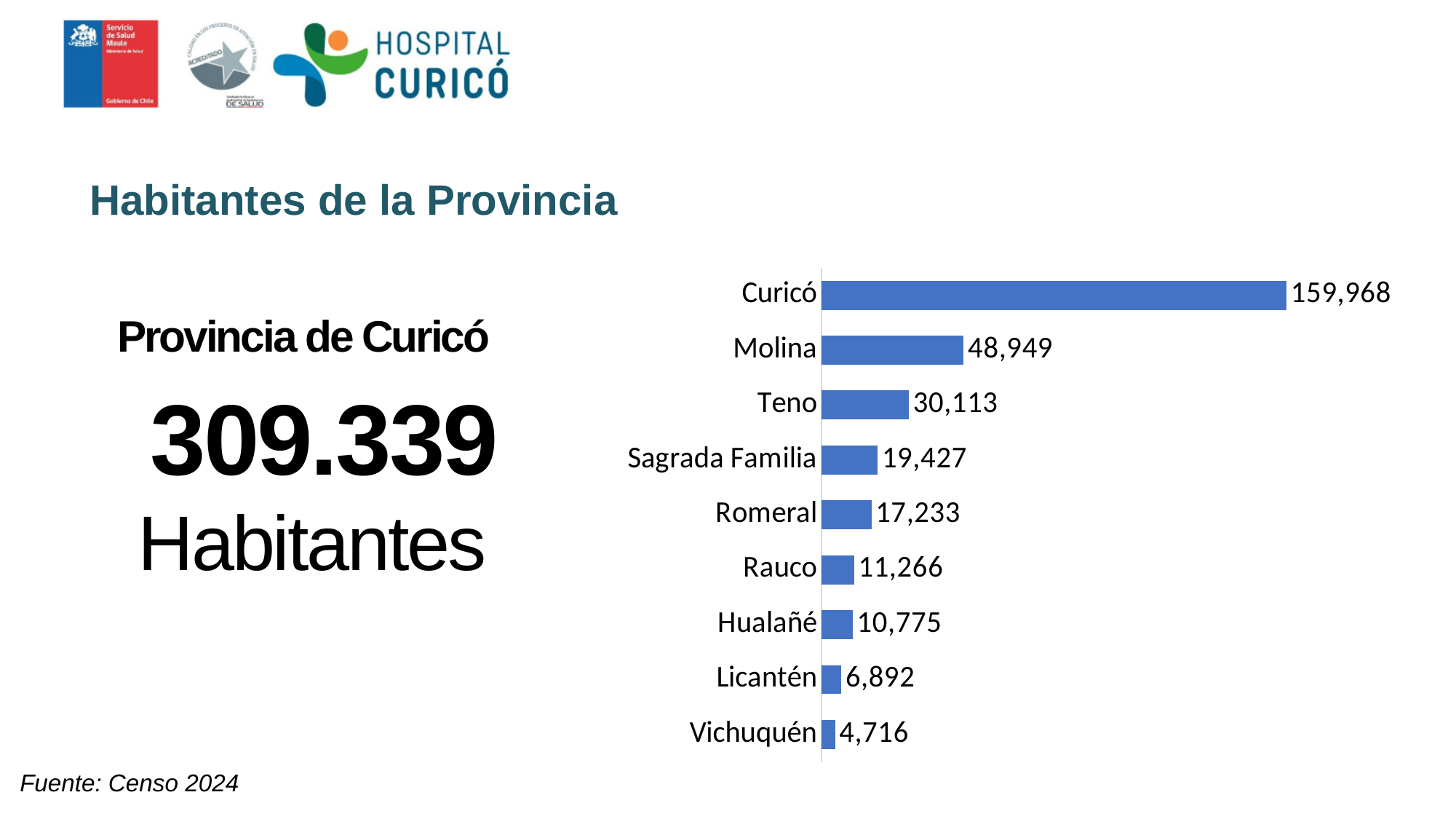
What is the value for Curicó? 159,968 What is the difference between the values for Molina and Teno? 18,836 Which category has the lowest value? Vichuquén Which category has the highest value? Curicó What is the value for Vichuquén? 4,716 What is the value for Sagrada Familia? 19,427 How many categories are shown in the chart? 9 What is the difference between the values for Rauco and Hualañé? 491 What kind of chart is shown on the slide? Bar chart What is the value for Molina? 48,949 Which is larger, the value for Romeral or the value for Licantén? Romeral What is the source cited at the bottom of the slide? Censo 2024